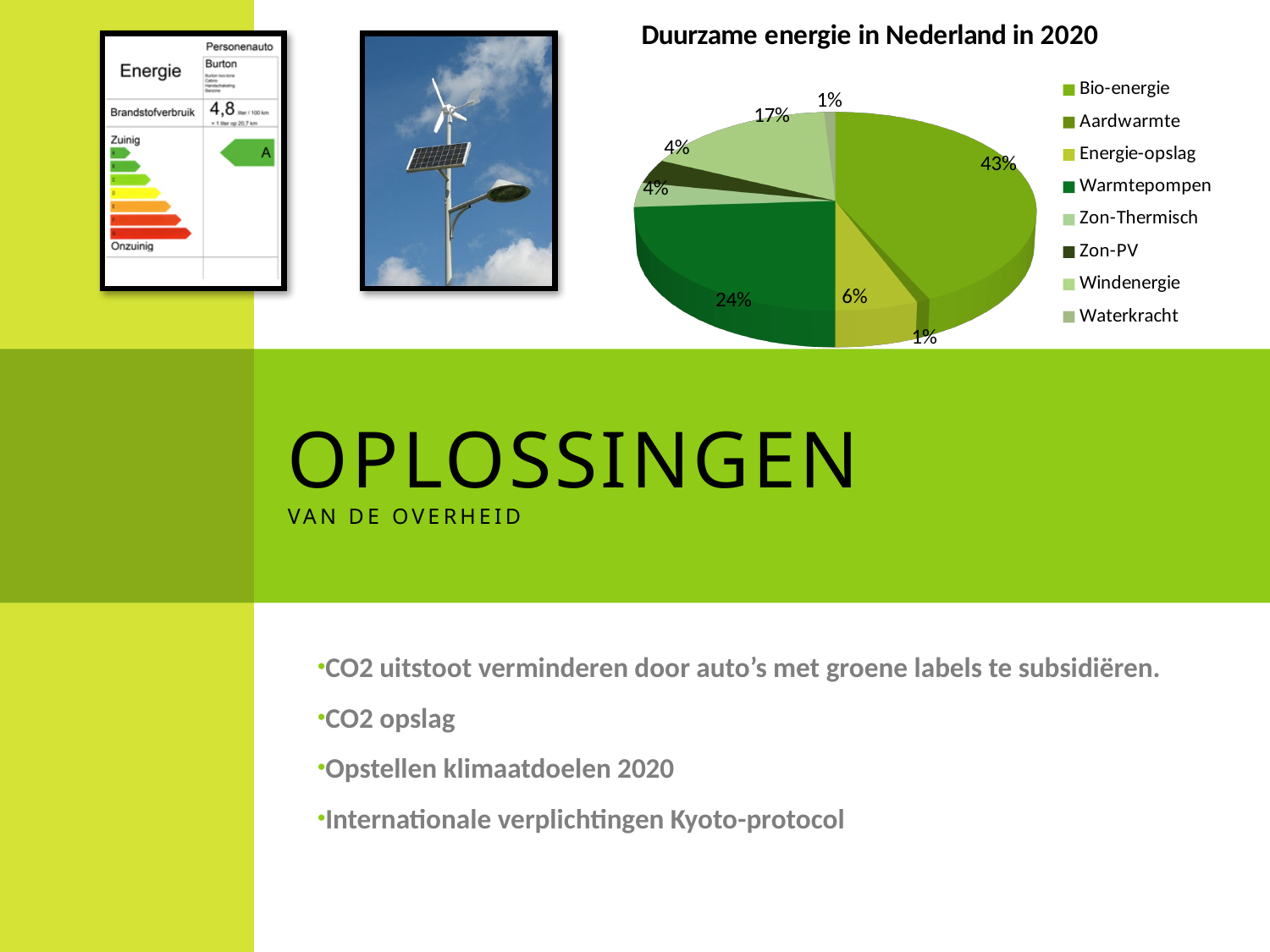
What percentage is shown for Zon-Thermisch? 4% What percentage is shown for Windenergie? 17% What percentage is shown for Energie-opslag? 6% What is the title of the chart on the slide? Duurzame energie in Nederland in 2020 What percentage is shown for Warmtepompen? 24% Which category has the largest slice of the pie? Bio-energie How many categories does the legend of the pie chart list? 8 What is the combined share of Zon-Thermisch and Zon-PV? 8% Which is larger, the share for Windenergie or the share for Energie-opslag? Windenergie What is the difference in percentage points between Bio-energie and Warmtepompen? 19% What share of the pie does Bio-energie have in the chart 'Duurzame energie in Nederland in 2020'? 43% What kind of chart is shown on the slide? Pie chart